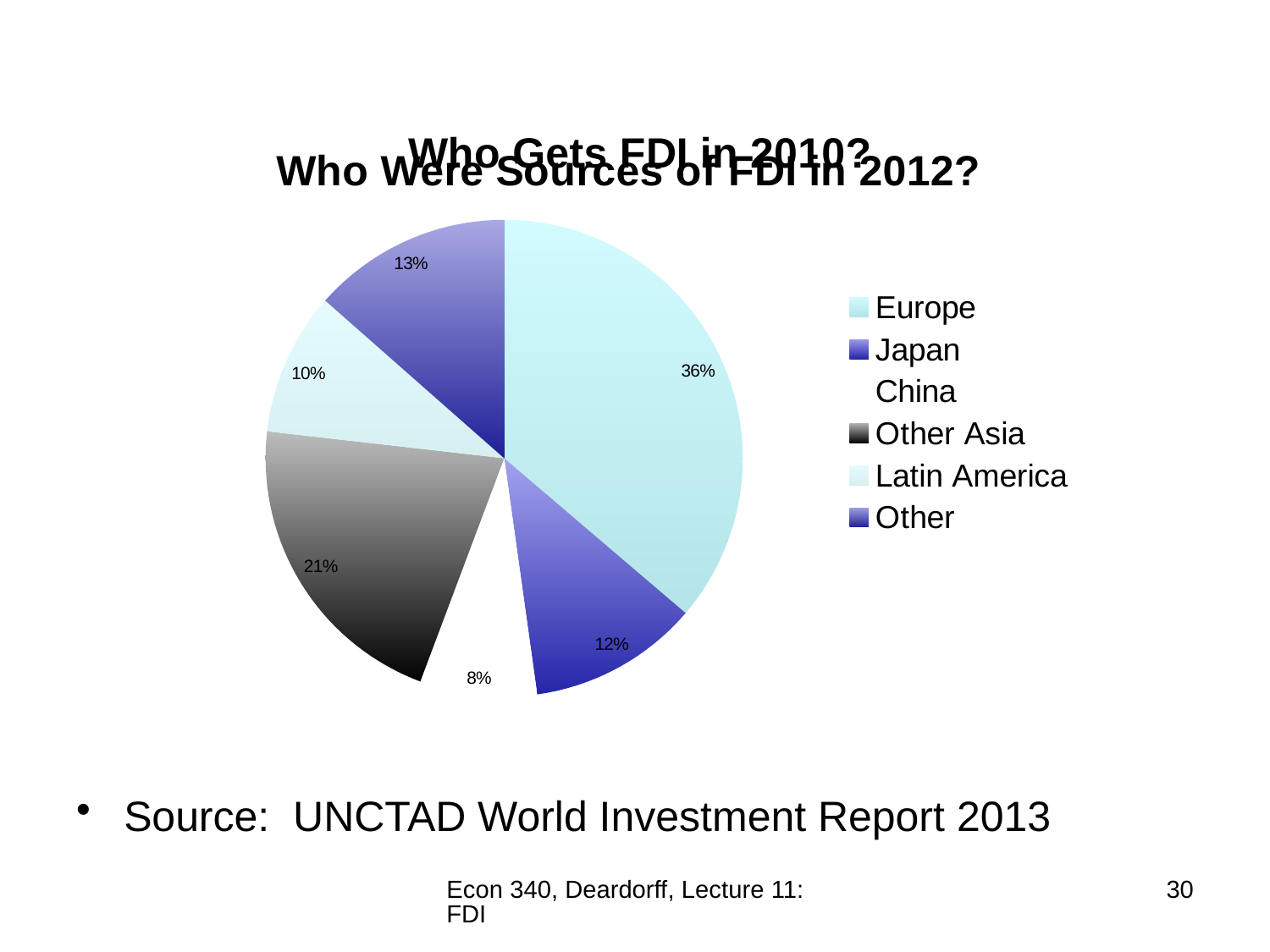
What share of the pie does Japan have? 12% What kind of chart is shown on the slide? pie chart What share of the pie does Latin America have? 10% What is the difference in percentage points between Europe's share and Other Asia's share? 15 What share of the pie does China have? 8% What share of the pie does Other Asia have? 21% What share of the pie does the Other category have? 13% Which category has the largest slice of the pie? Europe Which category has the smallest slice of the pie? China Which is larger, the share for Japan or the share for Other? Other What share of the pie does Europe have? 36% How many categories does the legend list? 6